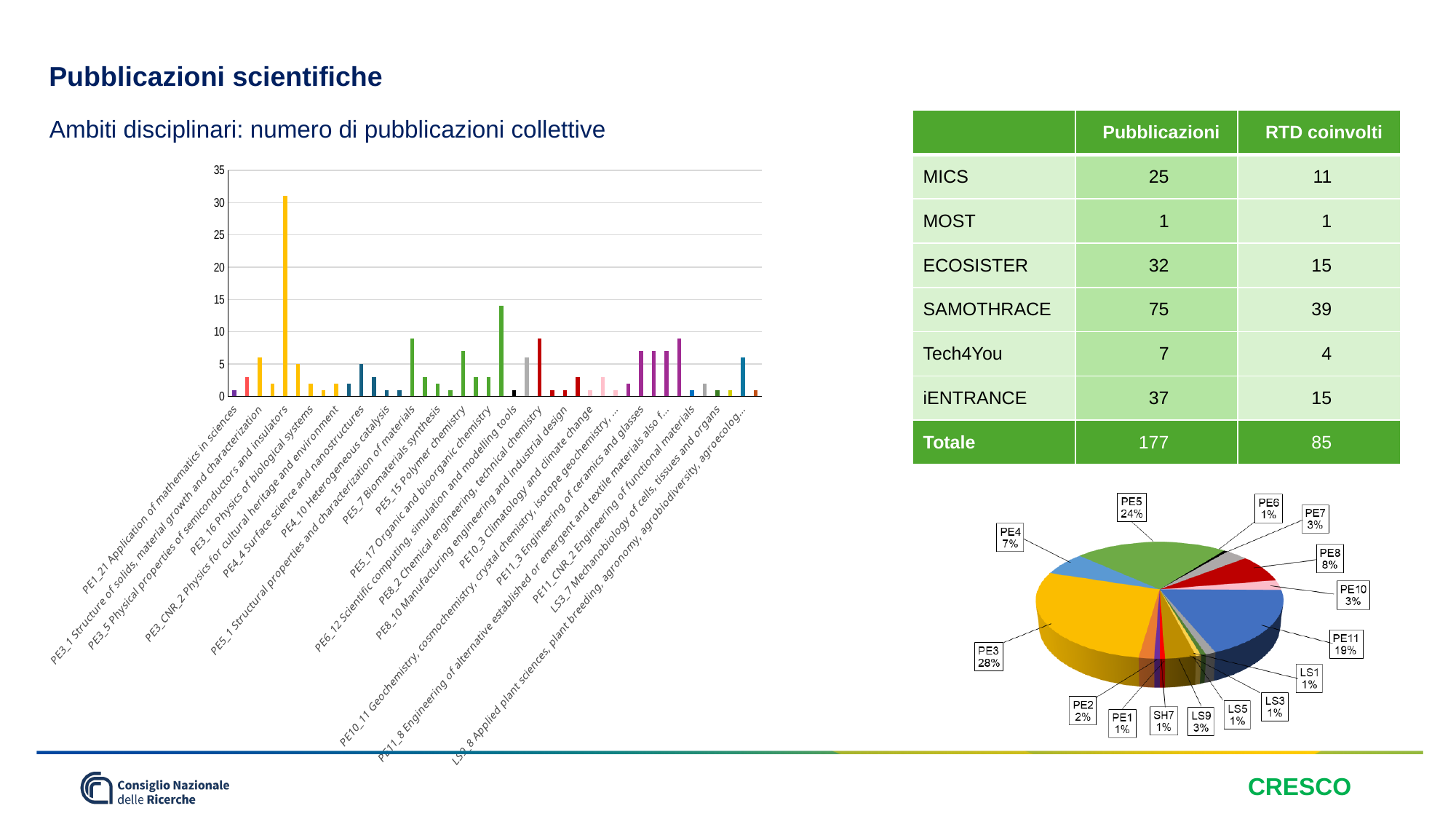
On the bar chart on the left, is the tallest bar greater or less than 25? greater On the pie chart at the bottom right, what share does PE3 have? 28% On the pie chart at the bottom right, which is larger, PE11 or PE8? PE11 On the pie chart at the bottom right, what is the difference in percentage points between PE3 and PE5? 4 On the pie chart at the bottom right, which slice is the largest? PE3 What kind of chart is the chart at the bottom right of the slide? pie chart On the pie chart at the bottom right, what share does PE4 have? 7% On the pie chart at the bottom right, what share does PE11 have? 19% What kind of chart is the chart on the left under 'Ambiti disciplinari: numero di pubblicazioni collettive'? bar chart On the pie chart at the bottom right, how many slices are labelled? 15 On the pie chart at the bottom right, what share does PE5 have? 24% On the bar chart on the left, what is the highest value shown on the vertical axis? 35